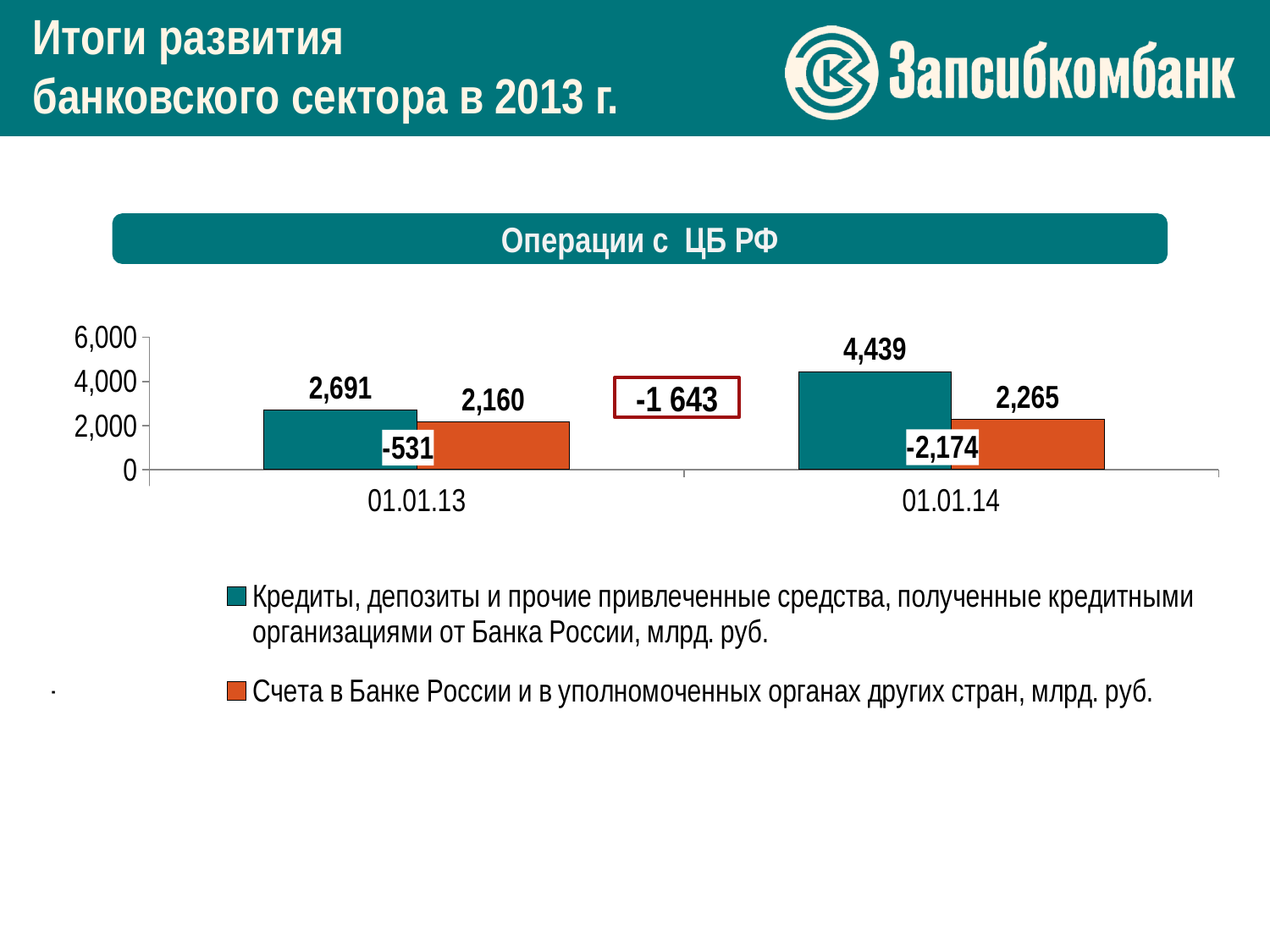
What is the value of "Кредиты, депозиты и прочие привлеченные средства, полученные кредитными организациями от Банка России" on 01.01.13? 2,691 What type of chart is shown under the title "Операции с ЦБ РФ"? bar chart What is the difference between the two series on 01.01.14? 2,174 How many dates are shown on the x axis? 2 What is the value of "Счета в Банке России и в уполномоченных органах других стран" on 01.01.13? 2,160 Does the value of "Кредиты, депозиты и прочие привлеченные средства, полученные кредитными организациями от Банка России" rise or fall from 01.01.13 to 01.01.14? rise What is the value of "Счета в Банке России и в уполномоченных органах других стран" on 01.01.14? 2,265 By how much did "Кредиты, депозиты и прочие привлеченные средства, полученные кредитными организациями от Банка России" increase from 01.01.13 to 01.01.14? 1,748 What colour are the bars for "Счета в Банке России и в уполномоченных органах других стран"? orange What is the value of "Кредиты, депозиты и прочие привлеченные средства, полученные кредитными организациями от Банка России" on 01.01.14? 4,439 Which series has the higher value on 01.01.14? Кредиты, депозиты и прочие привлеченные средства, полученные кредитными организациями от Банка России How many series does the legend list? 2